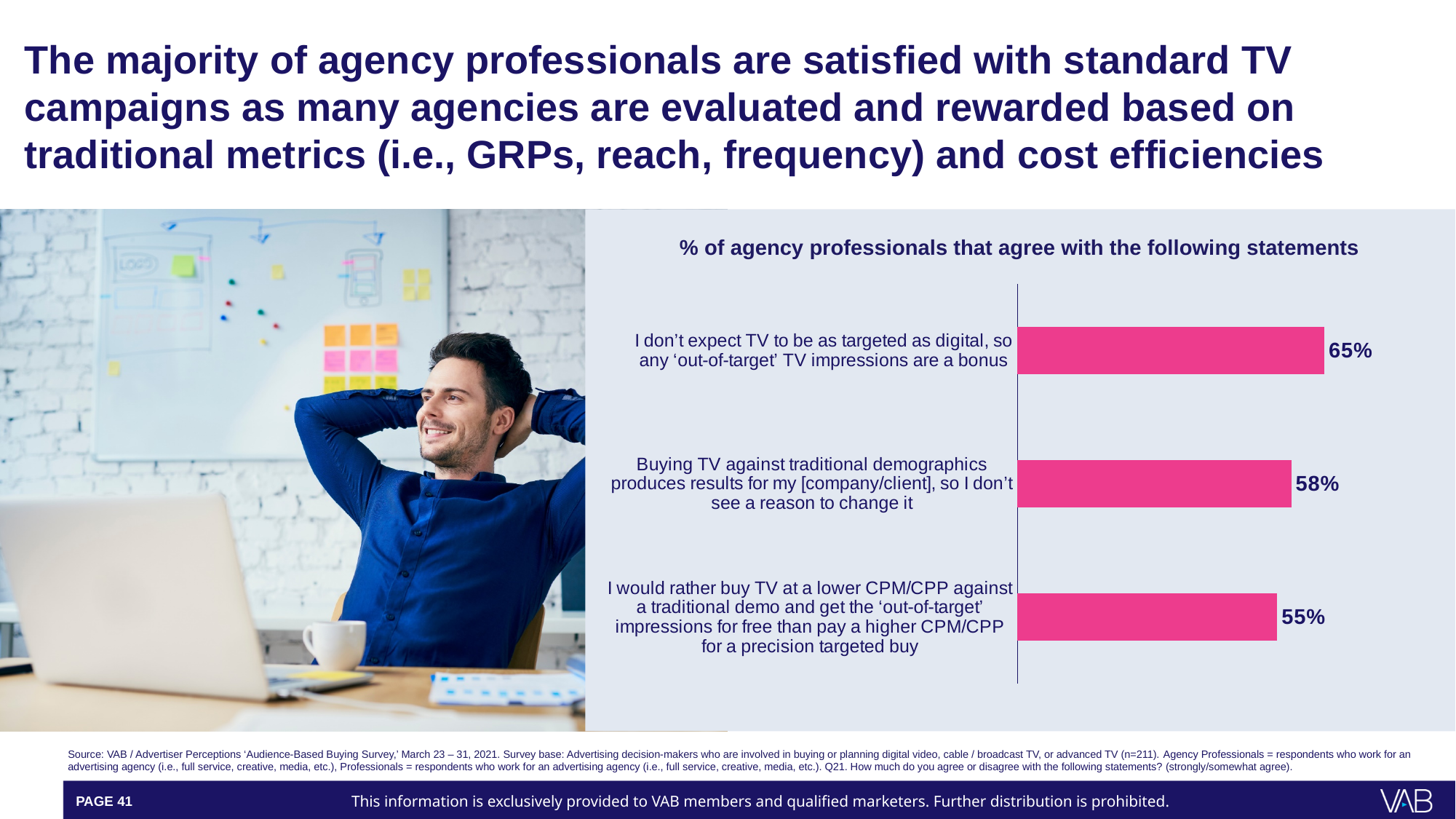
What percentage of agency professionals agree that buying TV against traditional demographics produces results so they don't see a reason to change it? 58% What is the title of the chart? % of agency professionals that agree with the following statements Which statement has the lowest share of agency professionals agreeing? I would rather buy TV at a lower CPM/CPP against a traditional demo and get the 'out-of-target' impressions for free than pay a higher CPM/CPP for a precision targeted buy Which statement has the highest share of agency professionals agreeing? I don't expect TV to be as targeted as digital, so any 'out-of-target' TV impressions are a bonus How many statements are shown in the chart? 3 What type of chart is shown on the slide? Bar chart What percentage of agency professionals agree with the statement "I don't expect TV to be as targeted as digital, so any 'out-of-target' TV impressions are a bonus"? 65% What percentage of agency professionals agree they would rather buy TV at a lower CPM/CPP against a traditional demo than pay a higher CPM/CPP for a precision targeted buy? 55% How many percentage points higher is agreement with the 'out-of-target impressions are a bonus' statement than with the 'traditional demographics produces results' statement? 7 percentage points Which has a higher agreement rate: the 'traditional demographics produces results' statement or the 'lower CPM/CPP' statement? The 'traditional demographics produces results' statement (58%) What colour are the bars in the chart? Pink What is the difference in percentage points between the highest and lowest bars in the chart? 10 percentage points